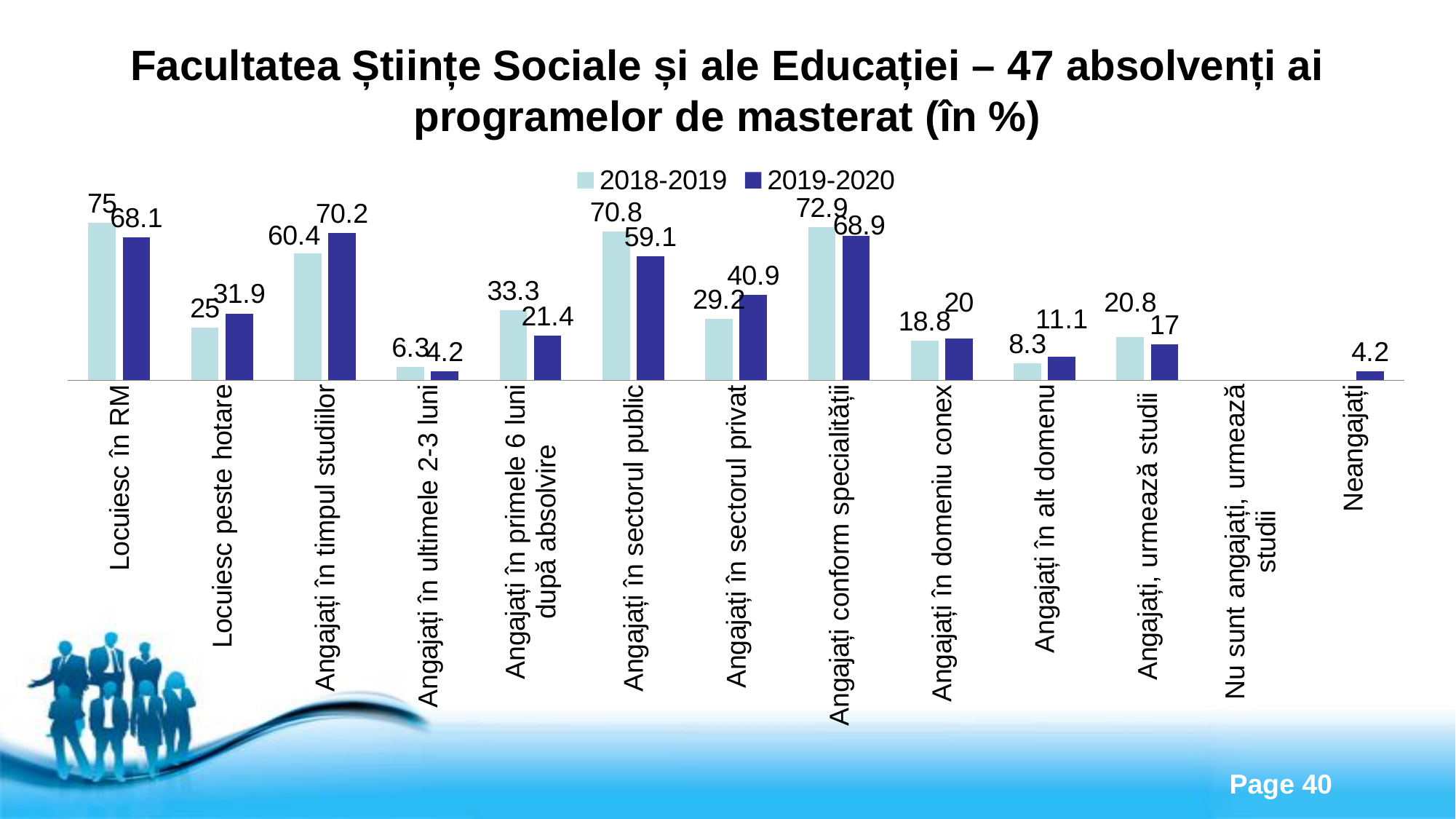
What is the 2018-2019 value for "Locuiesc în RM"? 75 What is the 2018-2019 value for "Angajați conform specialității"? 72.9 Which series is shown in dark blue in the legend? 2019-2020 What is the 2019-2020 value for "Angajați în sectorul privat"? 40.9 What is the difference between the 2018-2019 and 2019-2020 values for "Angajați în sectorul public"? 11.7 How many series does the legend list? 2 What is the 2019-2020 value for "Neangajați"? 4.2 Which is larger for "Angajați în primele 6 luni după absolvire": the 2018-2019 value or the 2019-2020 value? 2018-2019 Which category has the lowest 2018-2019 value among those with a 2018-2019 bar? Angajați în ultimele 2-3 luni Which is larger for "Locuiesc peste hotare": the 2018-2019 value or the 2019-2020 value? 2019-2020 What kind of chart is shown on the slide? Bar chart Which category has the highest 2019-2020 value? Angajați în timpul studiilor